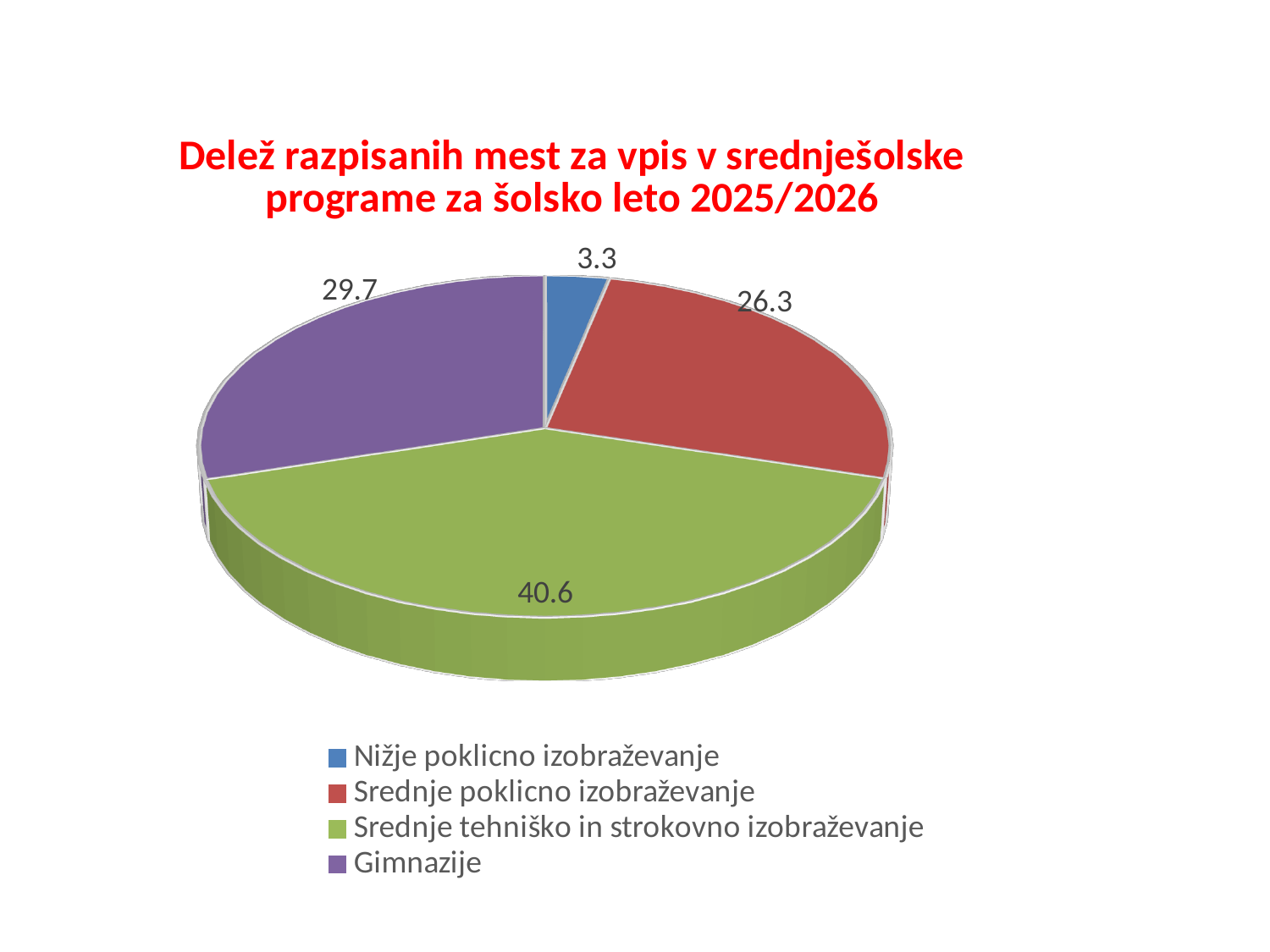
Which category has the smallest slice? Nižje poklicno izobraževanje What is the value for Gimnazije? 29.7 What is the value for Srednje poklicno izobraževanje? 26.3 How many categories does the pie chart show? 4 What is the title of the chart? Delež razpisanih mest za vpis v srednješolske programe za šolsko leto 2025/2026 What is the value for Nižje poklicno izobraževanje? 3.3 Which category has the largest slice? Srednje tehniško in strokovno izobraževanje Which is larger, the value for Gimnazije or the value for Srednje poklicno izobraževanje? Gimnazije What is the value for Srednje tehniško in strokovno izobraževanje? 40.6 What is the difference between the values for Gimnazije and Srednje poklicno izobraževanje? 3.4 What kind of chart is shown on the slide? Pie chart Which colour represents Gimnazije in the legend? Purple